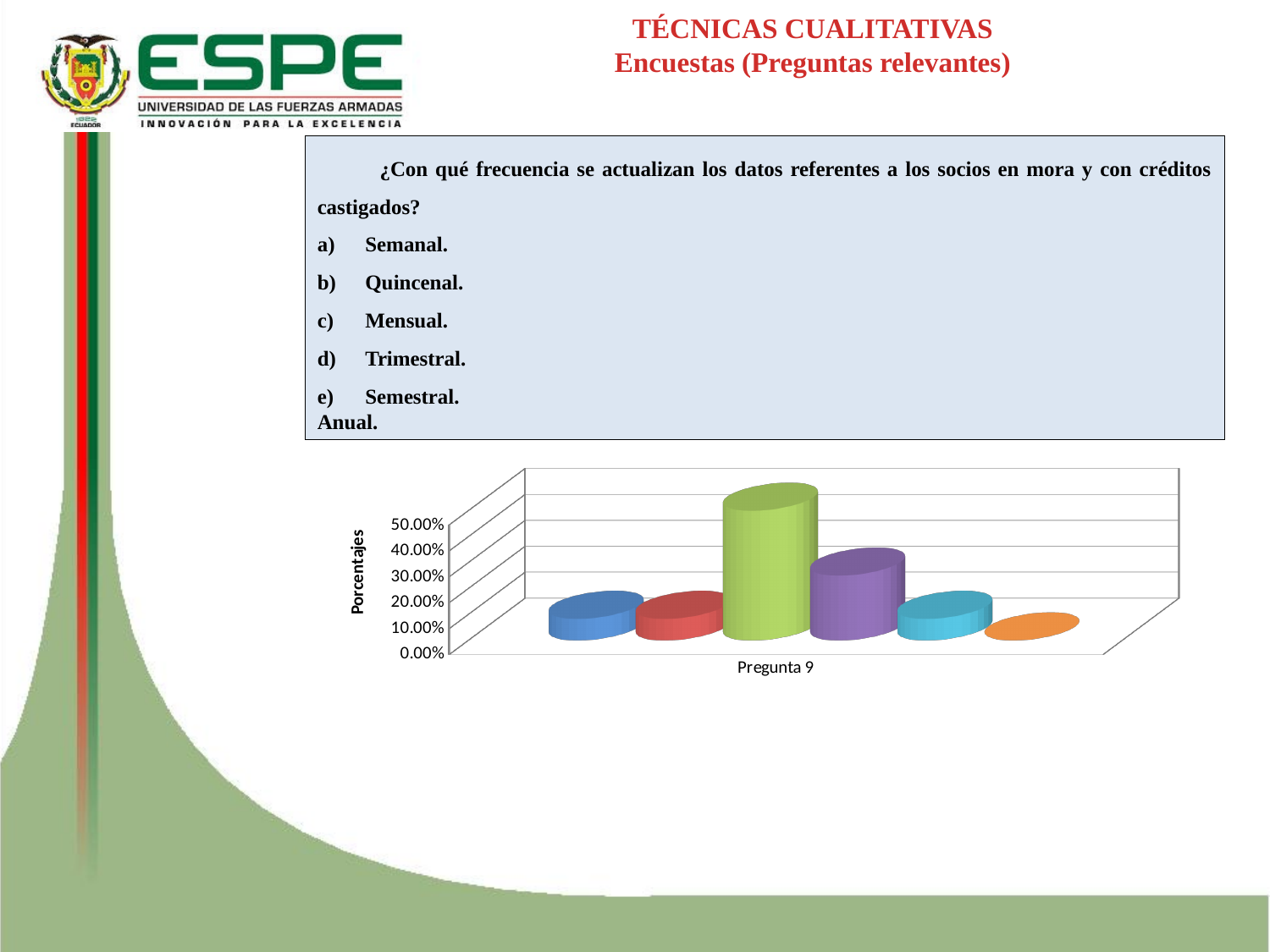
Is the value of the blue bar greater or less than 20.00%? less How many bars are plotted in the chart? 6 What label appears under the horizontal axis of the chart? Pregunta 9 What is the title of the vertical axis of the chart? Porcentajes Is the value of the green bar greater or less than 30.00%? greater Which bar is the tallest in the chart? the green bar (third from left) Is the value of the orange bar greater or less than 10.00%? less Which is larger, the green bar or the purple bar? the green bar Which bar is the shortest in the chart? the orange bar (rightmost) What kind of chart is shown on the slide? bar chart Which is larger, the blue bar or the orange bar? the blue bar